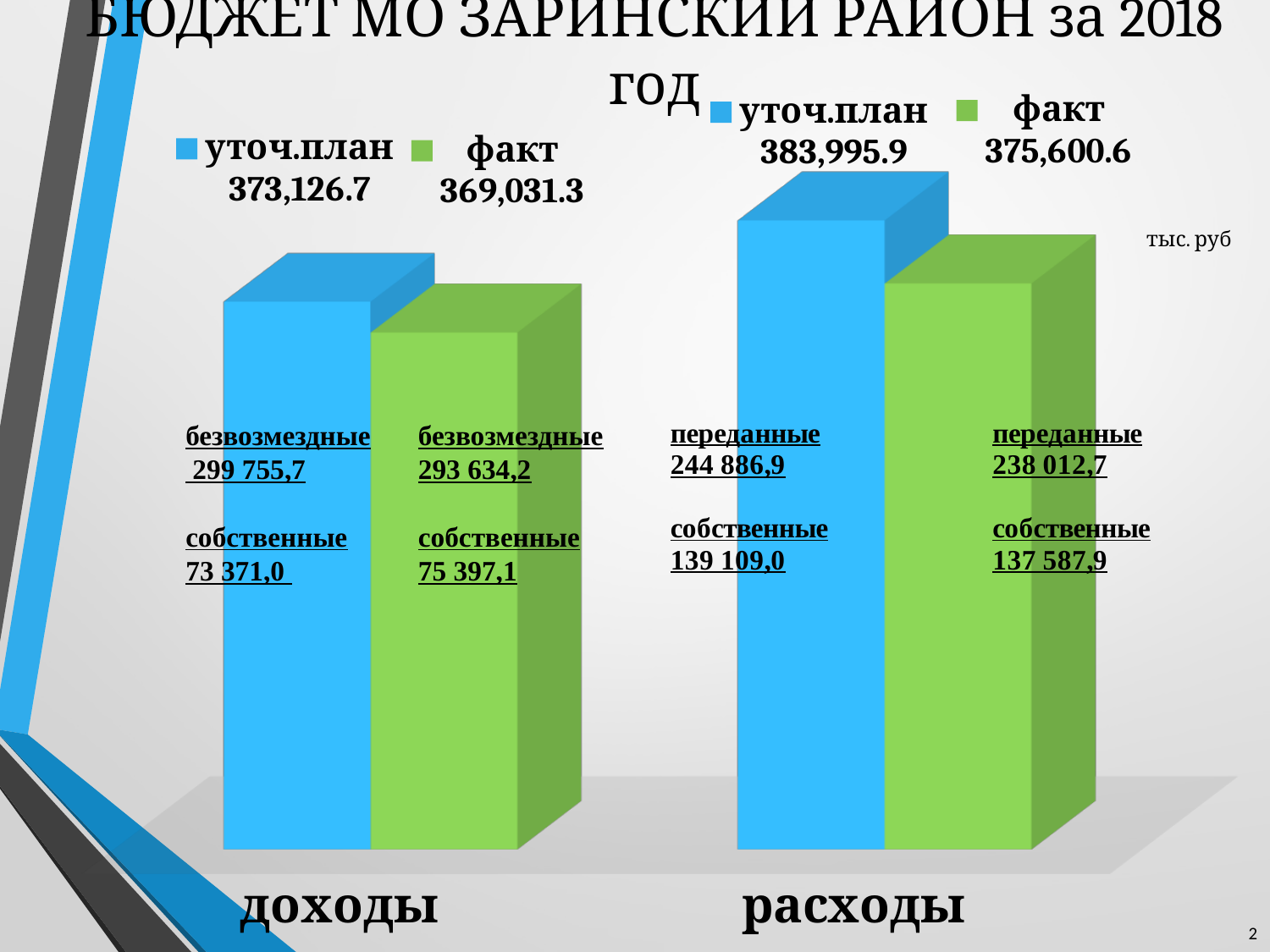
How many series does the legend of the доходы chart list? 2 In the доходы chart, which series has the higher value, уточ.план or факт? уточ.план In the доходы chart, what is the собственные amount shown for уточ.план? 73 371,0 What unit is indicated for the values on the slide? тыс. руб In the доходы chart, what is the difference between уточ.план and факт? 4,095.4 In the расходы chart, what is the difference between уточ.план and факт? 8,395.3 In the расходы chart, what is the value for уточ.план? 383,995.9 What kind of chart is the расходы chart? bar chart In the расходы chart, what is the value for факт? 375,600.6 In the расходы chart, which series has the lowest value? факт In the доходы chart, what is the value for факт? 369,031.3 In the доходы chart, what is the value for уточ.план? 373,126.7